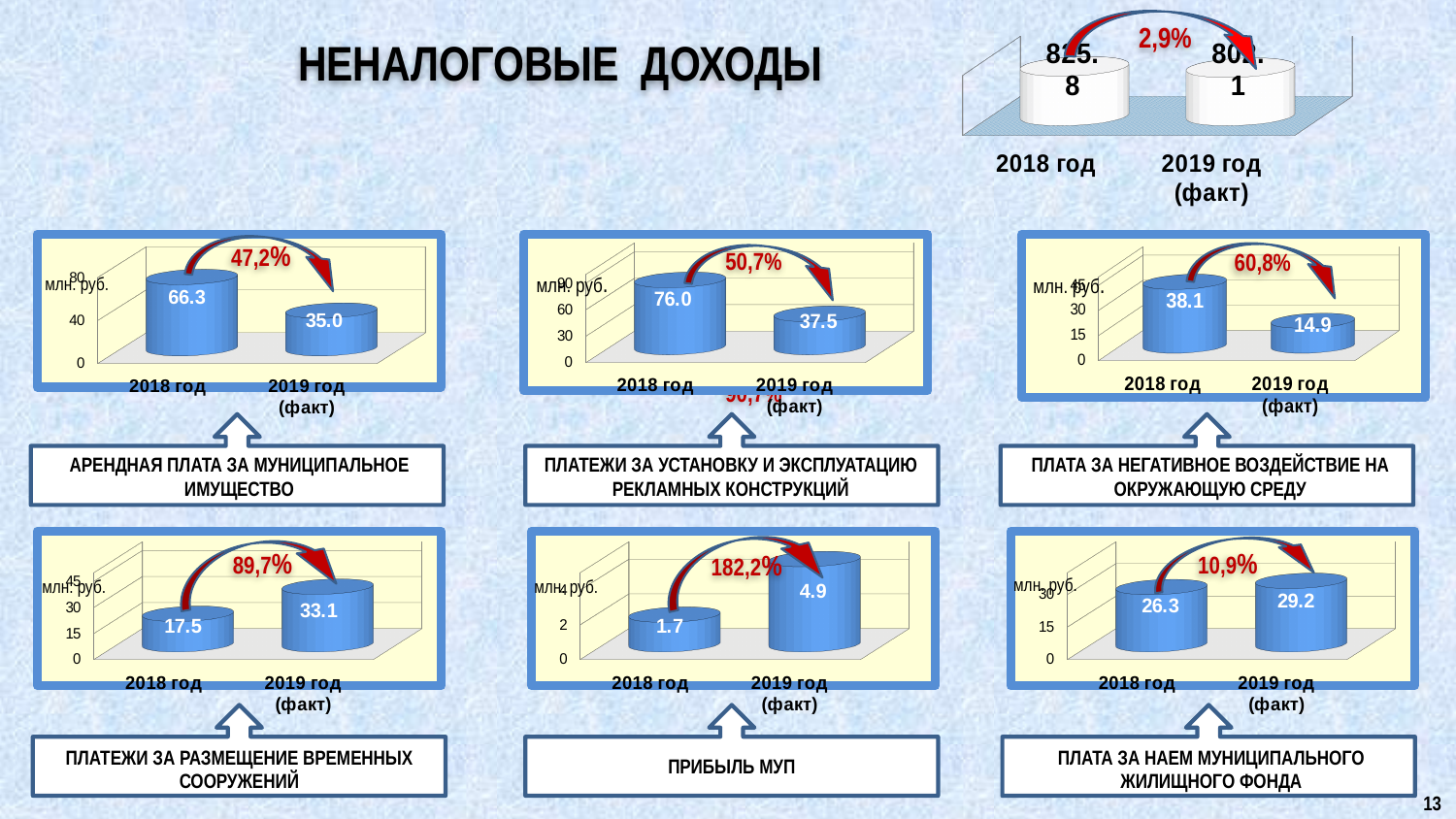
What percentage change is printed above the chart for «Прибыль МУП»? 182,2% In the chart for «Арендная плата за муниципальное имущество», what is the difference between the 2018 and 2019 values? 31.3 In the chart for «Плата за негативное воздействие на окружающую среду», what is the value for 2018 год? 38.1 In the chart for «Арендная плата за муниципальное имущество», what is the value for 2018 год? 66.3 How many bars are shown in the chart for «Плата за наем муниципального жилищного фонда»? 2 In the chart for «Прибыль МУП», what is the value for 2019 год (факт)? 4.9 In the chart for «Платежи за установку и эксплуатацию рекламных конструкций», do the values rise or fall from 2018 to 2019? fall In the chart for «Платежи за установку и эксплуатацию рекламных конструкций», what is the value for 2019 год (факт)? 37.5 In the chart for «Плата за негативное воздействие на окружающую среду», what is the difference between the 2018 and 2019 values? 23.2 In the chart for «Плата за наем муниципального жилищного фонда», which year has the lower value? 2018 год In the chart for «Платежи за размещение временных сооружений», which year has the higher value? 2019 год (факт) In the chart for «Прибыль МУП», is the value for 2018 год larger or smaller than the value for 2019 год (факт)? smaller